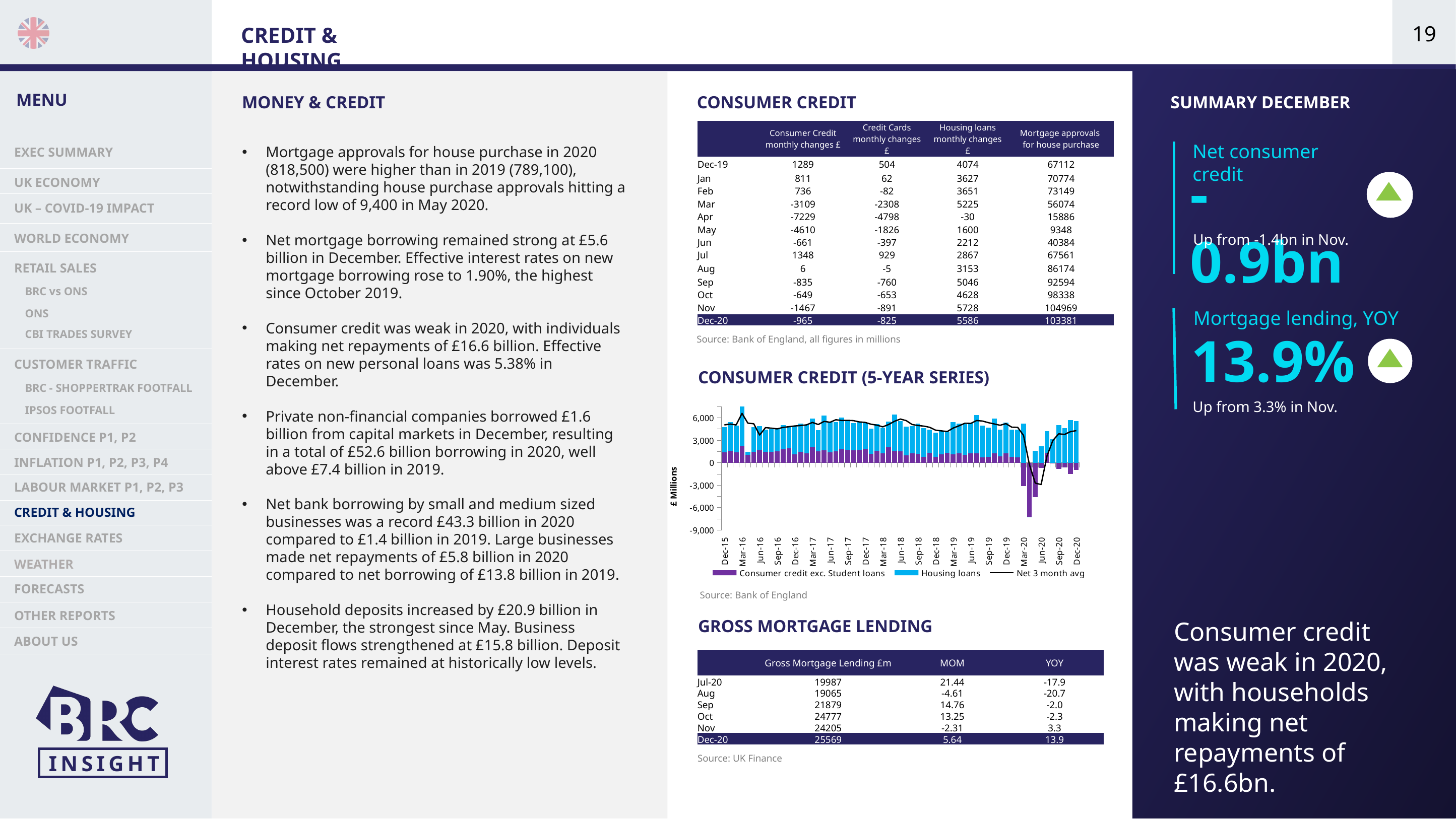
What kind of chart is the Consumer Credit (5-Year Series) chart? Stacked bar chart with a line On the Consumer Credit (5-Year Series) chart, is the lowest bar value greater or less than -6,000? less What are the three series listed in the legend of the Consumer Credit (5-Year Series) chart? Consumer credit exc. Student loans, Housing loans, Net 3 month avg What is the y-axis label on the Consumer Credit (5-Year Series) chart? £ Millions On the Consumer Credit (5-Year Series) chart, is the Net 3 month avg line at Dec-20 greater or less than 3,000? greater How many series does the legend of the Consumer Credit (5-Year Series) chart list? 3 On the Consumer Credit (5-Year Series) chart, does the Net 3 month avg line rise or fall between Jun-20 and Dec-20? rise On the Consumer Credit (5-Year Series) chart, is the lowest point of the Net 3 month avg line greater or less than 0? less In which part of the Consumer Credit (5-Year Series) chart does the lowest bar value occur? Between Mar-20 and Jun-20